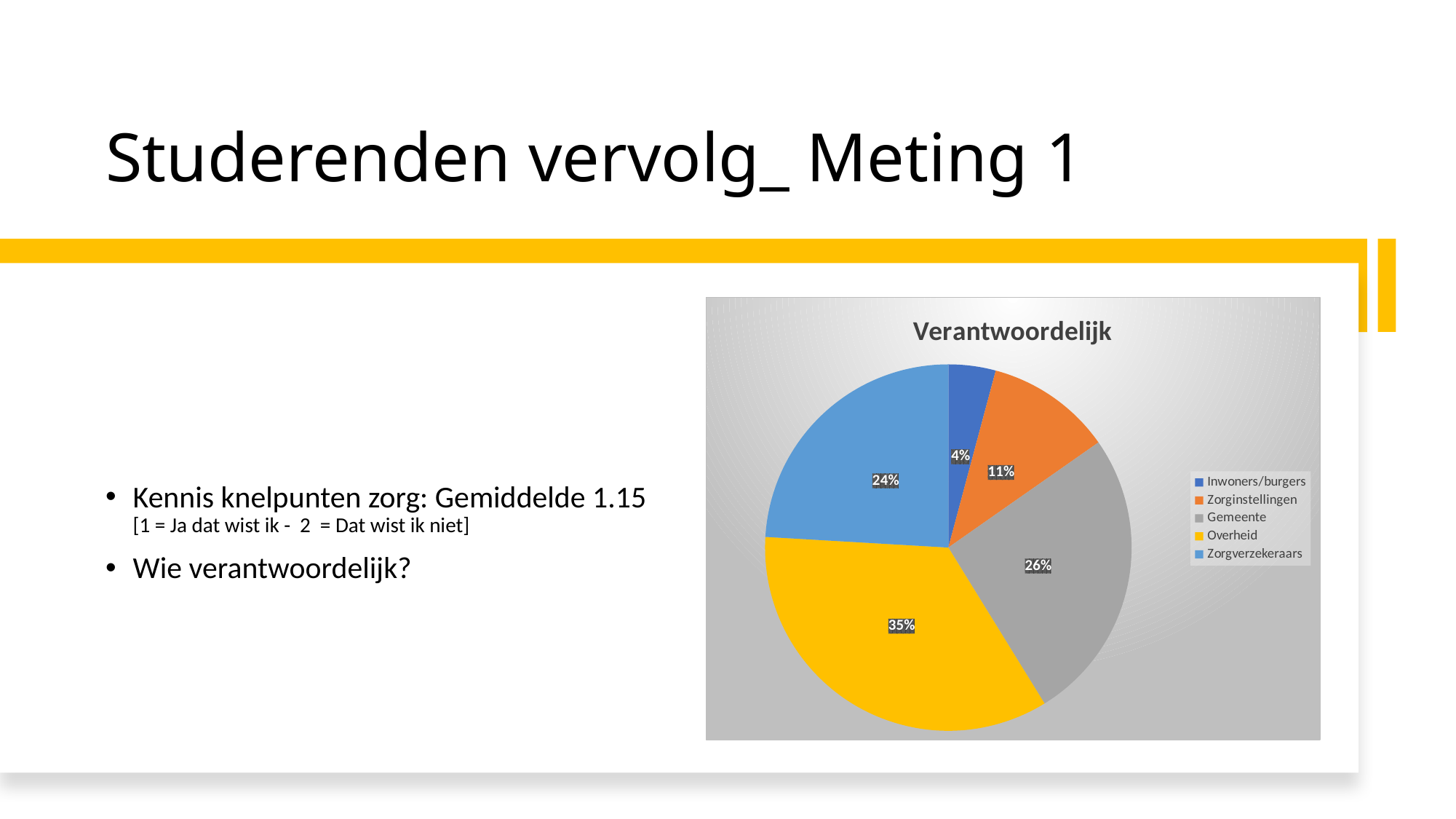
What share of the pie does Zorgverzekeraars have? 24% What share of the pie does Overheid have? 35% What share of the pie does Zorginstellingen have? 11% Which has a larger share, Zorgverzekeraars or Zorginstellingen? Zorgverzekeraars What share of the pie does Gemeente have? 26% What share of the pie does Inwoners/burgers have? 4% How many categories does the legend list? 5 Which category has the largest share of the pie? Overheid What is the title of the chart? Verantwoordelijk What kind of chart is shown on the slide? pie chart Which category has the smallest share of the pie? Inwoners/burgers What is the difference in percentage points between Overheid and Gemeente? 9